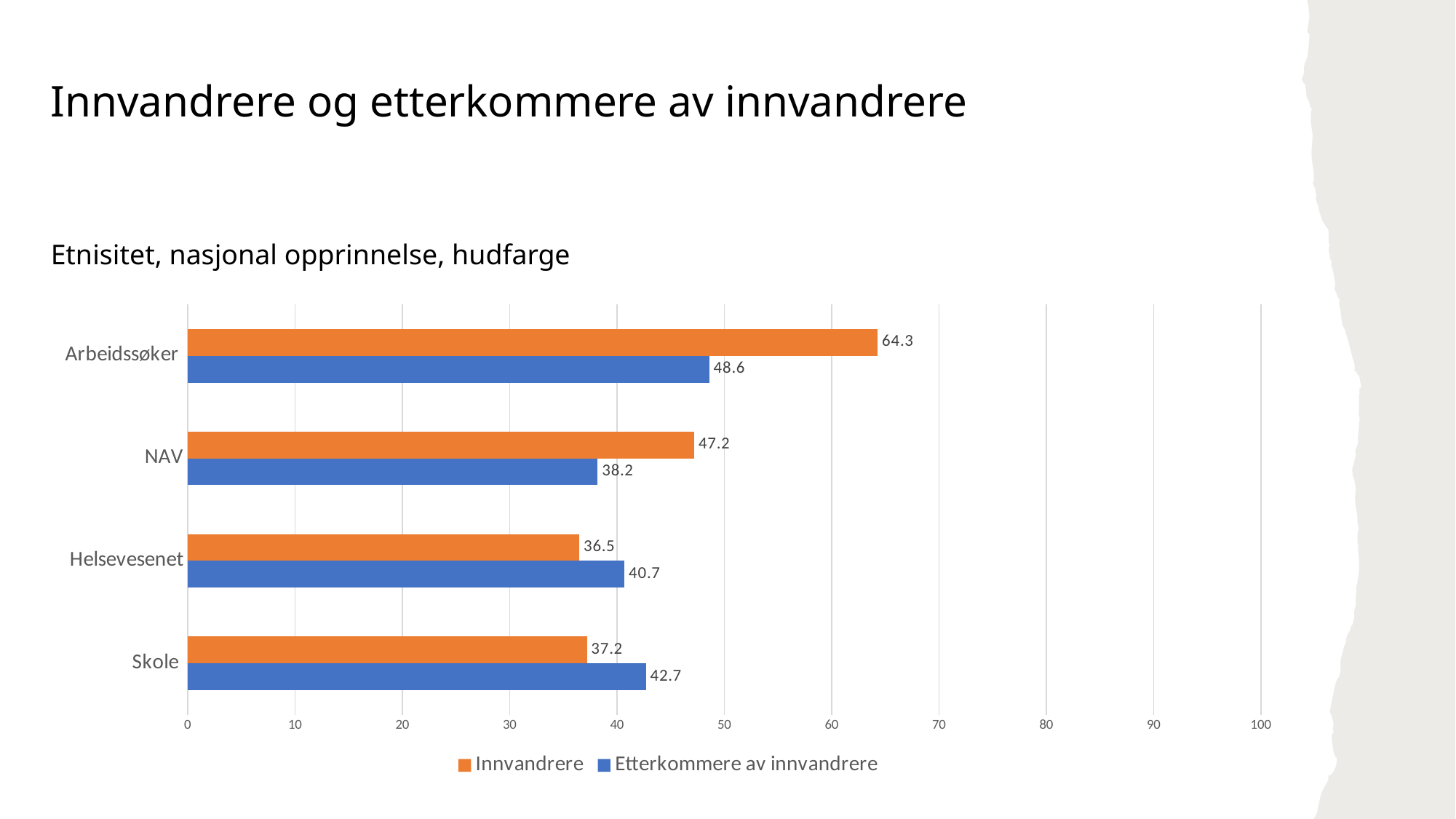
What kind of chart is shown on the slide? Bar chart What is the difference between the Innvandrere and Etterkommere av innvandrere values for Arbeidssøker? 15.7 Which is larger for Helsevesenet: the Innvandrere value or the Etterkommere av innvandrere value? Etterkommere av innvandrere What is the value for Innvandrere in the Arbeidssøker category? 64.3 Is the value for Innvandrere in the NAV category greater or less than 40? greater Which colour represents the Innvandrere series? Orange Which category has the lowest value for Etterkommere av innvandrere? NAV How many series does the legend list? 2 What is the value for Etterkommere av innvandrere in the Skole category? 42.7 What is the value for Etterkommere av innvandrere in the NAV category? 38.2 Which category has the highest value for Innvandrere? Arbeidssøker How many categories are shown on the chart? 4